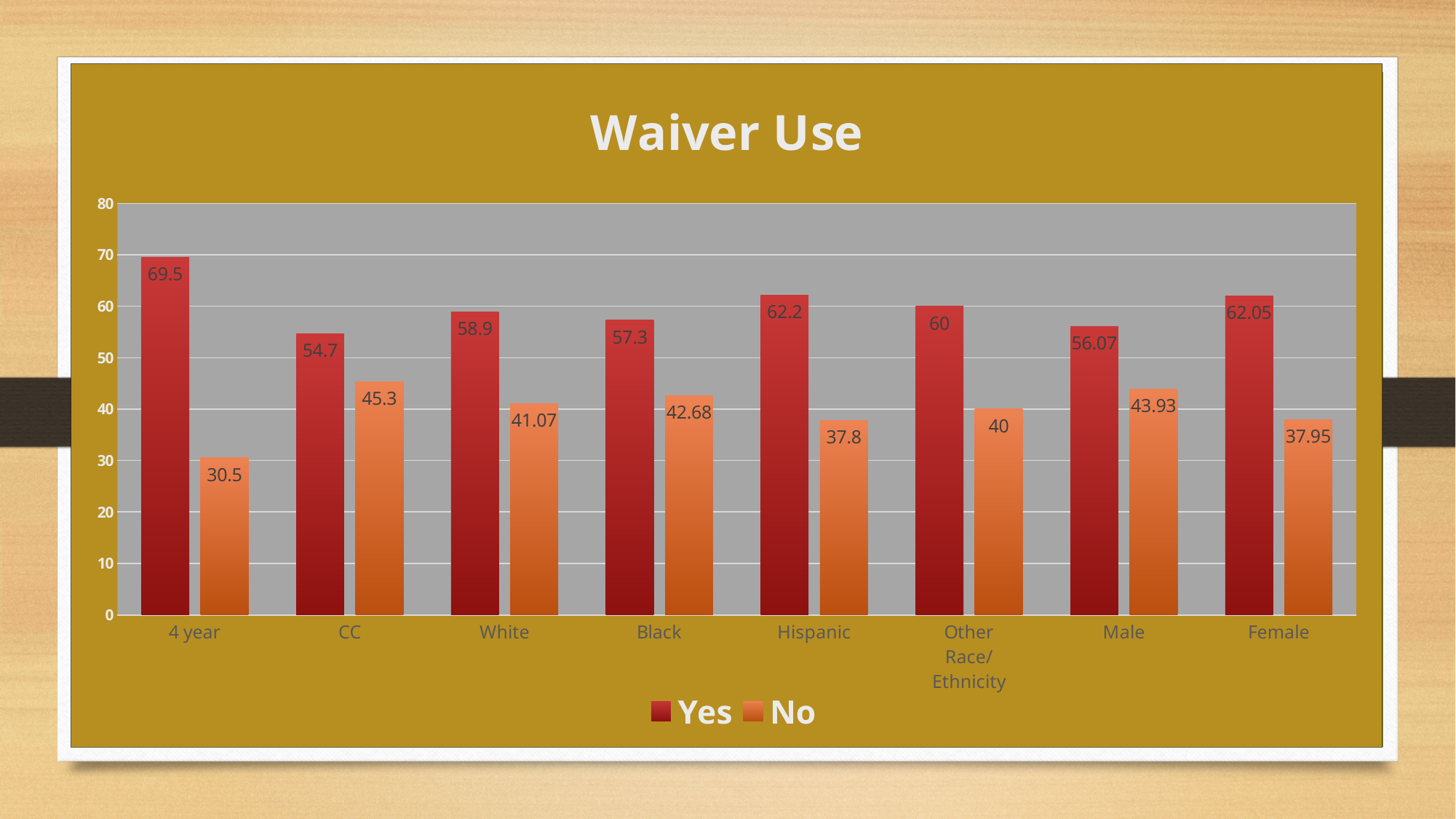
What is the No value for Other Race/Ethnicity? 40 What is the title of the chart? Waiver Use Which category has the lowest No value? 4 year Which category has the highest Yes value? 4 year What is the Yes value for 4 year? 69.5 How many categories are shown on the x axis? 8 What is the difference between the Yes and No values for CC? 9.4 What is the No value for Male? 43.93 Which is larger, the No value for White or the No value for Black? Black Is the Yes value for Hispanic greater or less than 60? greater What kind of chart is shown? bar chart How many series does the legend list? 2